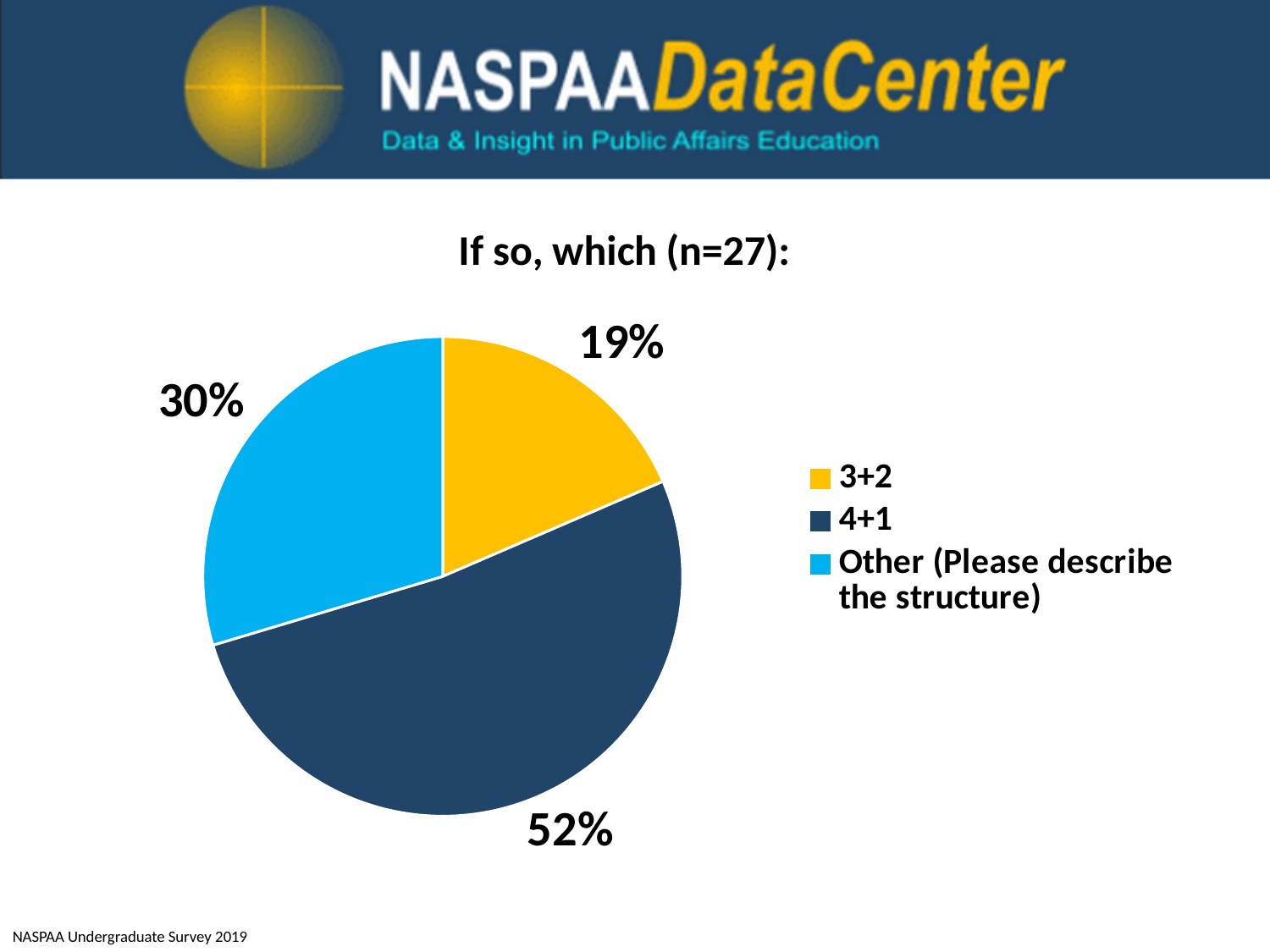
What is the difference in percentage points between the Other (Please describe the structure) slice and the 3+2 slice? 11 What share of the pie does the 3+2 slice represent? 19% Which category has the smallest slice of the pie? 3+2 What is the difference in percentage points between the 4+1 slice and the 3+2 slice? 33 What is the title of the chart? If so, which (n=27): What colour is the 3+2 slice? yellow What kind of chart is shown on the slide? pie chart What share of the pie does the 4+1 slice represent? 52% Which category has the largest slice of the pie? 4+1 Which is larger, the 4+1 slice or the Other (Please describe the structure) slice? 4+1 How many categories does the legend list? 3 What share of the pie does the Other (Please describe the structure) slice represent? 30%